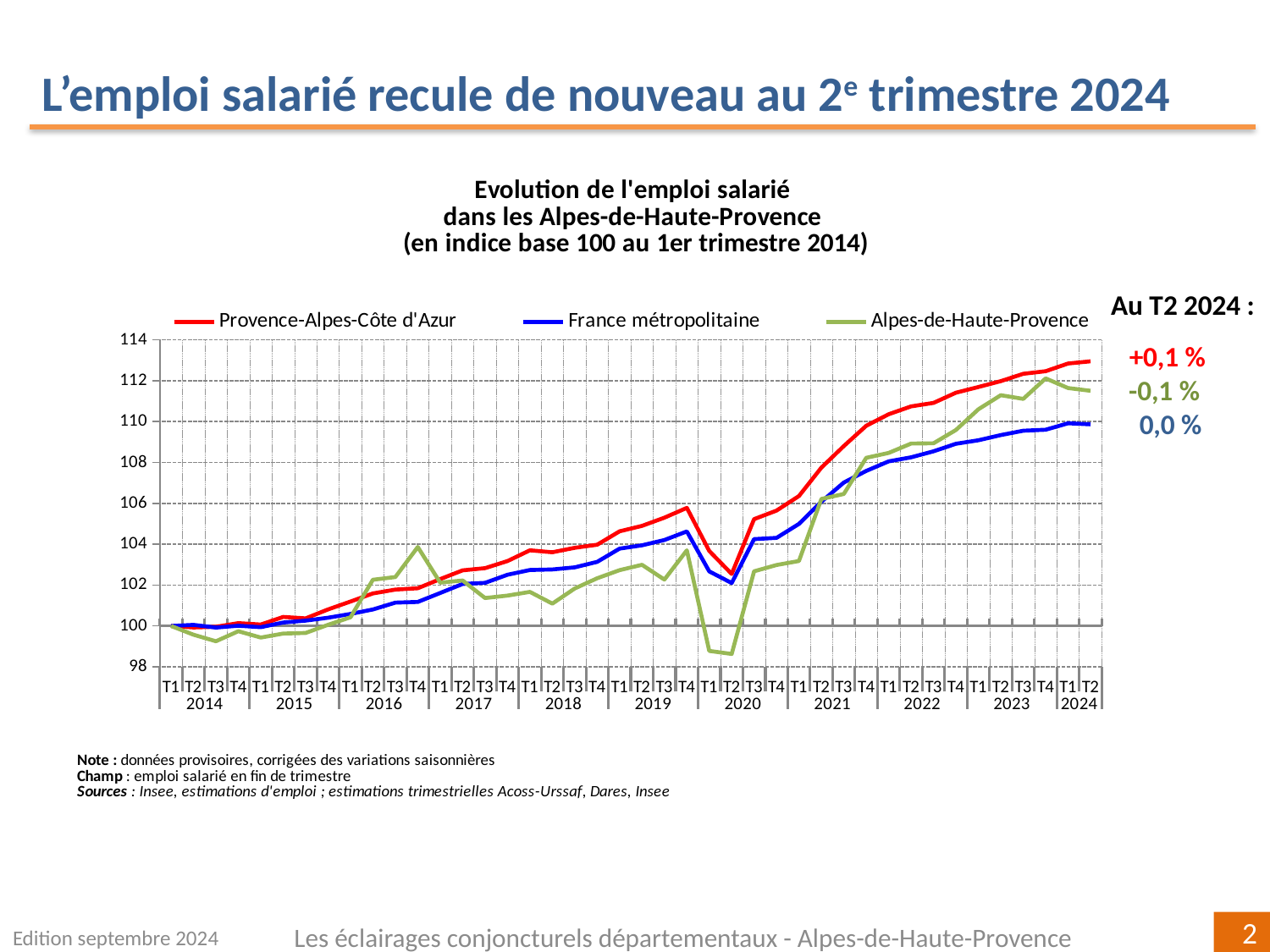
Is the value for Alpes-de-Haute-Provence at T2 2020 greater or less than 100? less Is the value for Alpes-de-Haute-Provence at T4 2016 greater or less than 102? greater What kind of chart is shown on the slide? line chart How many series does the legend list? 3 According to the annotation 'Au T2 2024', what is the change shown for Alpes-de-Haute-Provence? -0,1 % Overall, do the index values rise or fall between T1 2014 and T2 2024? rise Which series has the lowest index value at T2 2020? Alpes-de-Haute-Provence Which series is drawn in red? Provence-Alpes-Côte d'Azur Is the value for Provence-Alpes-Côte d'Azur at T2 2024 greater or less than 112? greater Which series has the highest index value at T2 2024? Provence-Alpes-Côte d'Azur According to the annotation 'Au T2 2024', what is the change shown for Provence-Alpes-Côte d'Azur? +0,1 % According to the annotation 'Au T2 2024', what is the change shown for France métropolitaine? 0,0 %